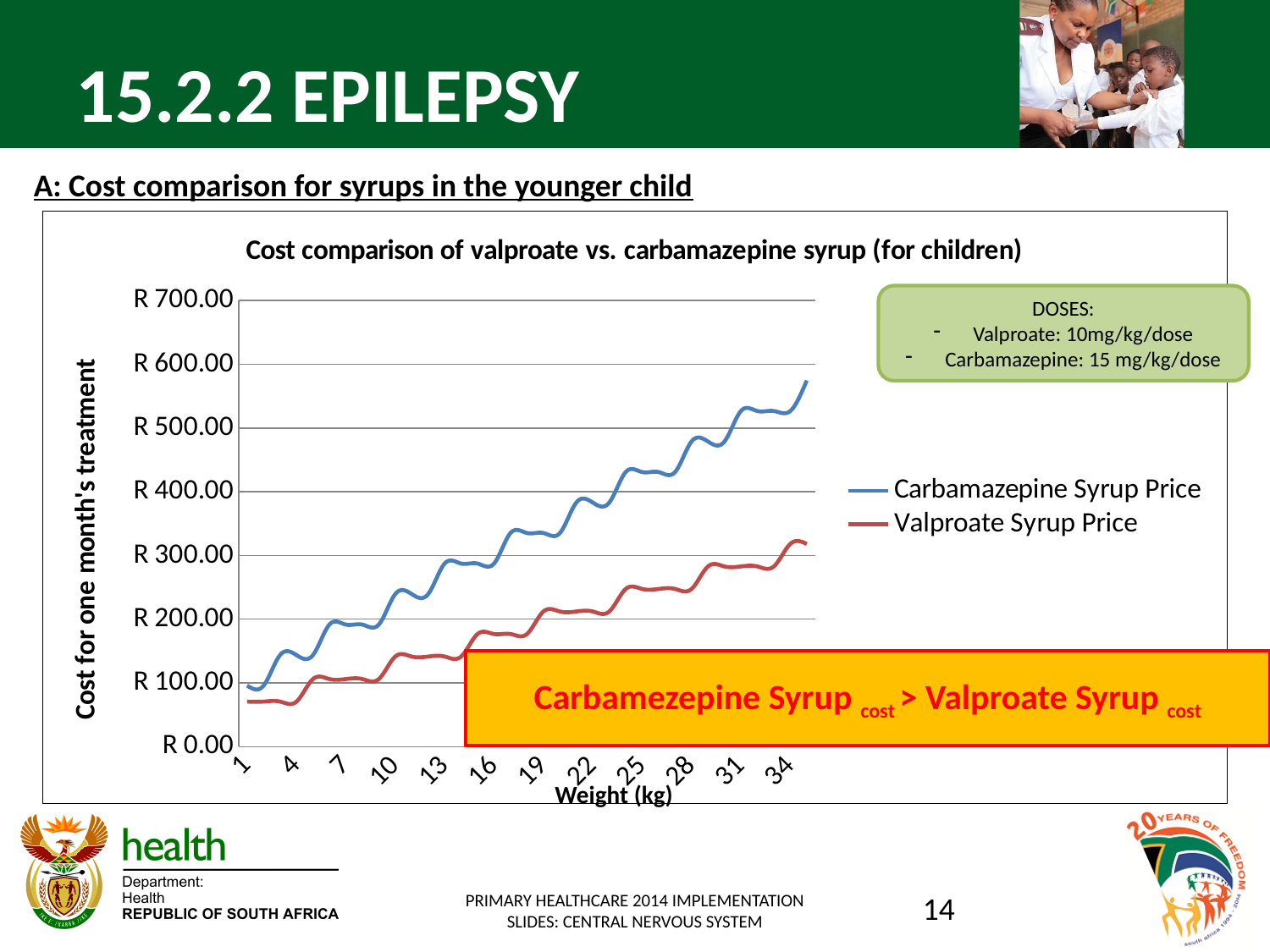
Which series is higher at a weight of 34 kg, Carbamazepine Syrup Price or Valproate Syrup Price? Carbamazepine Syrup Price Is the Carbamazepine Syrup Price at a weight of 34 kg greater or less than R 500.00? greater Is the Carbamazepine Syrup Price at a weight of 25 kg greater or less than R 400.00? greater What is the title of the chart? Cost comparison of valproate vs. carbamazepine syrup (for children) How many weight values are labelled on the x axis of the chart? 12 What is the label of the vertical axis of the chart? Cost for one month's treatment How many series does the chart legend list? 2 Does the Carbamazepine Syrup Price rise or fall as weight increases along the x axis? rise Does the Valproate Syrup Price rise or fall as weight increases along the x axis? rise What kind of chart is shown on the slide? line chart Is the Valproate Syrup Price at a weight of 34 kg greater or less than R 400.00? less